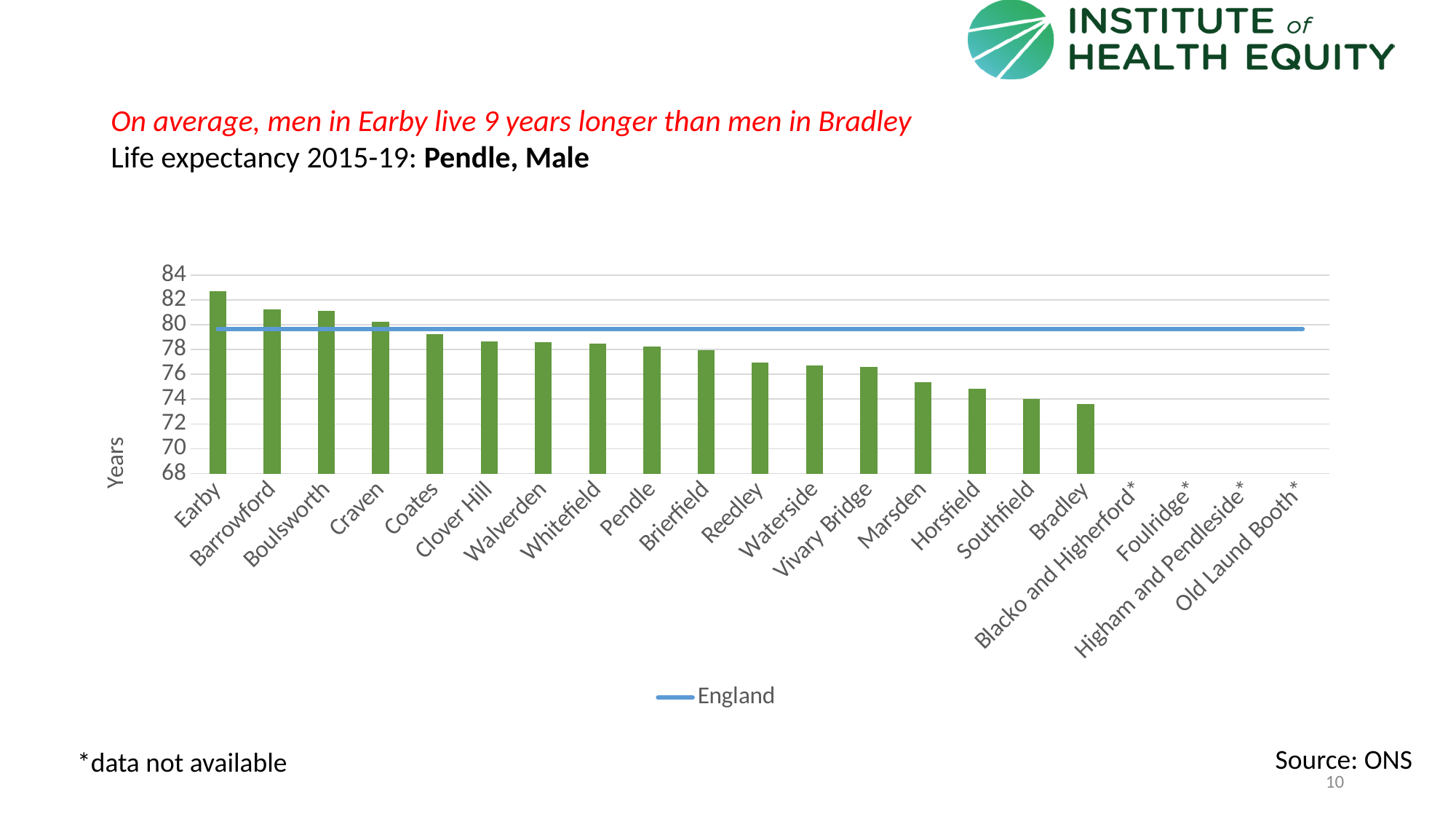
Is the value for Bradley greater or less than 76? less Do the bar values rise or fall from left to right along the x axis? fall Which is larger, the value for Barrowford or the value for Reedley? Barrowford What entry does the chart legend list? England Is the value for Earby greater or less than 82? greater Among the wards with a bar plotted, which has the lowest male life expectancy? Bradley What kind of chart is shown on the slide? a bar chart with a line (combination bar and line chart) How many wards are listed on the x axis of the chart? 21 Is the value for Pendle greater or less than 76? greater Which ward has the highest male life expectancy in the chart? Earby